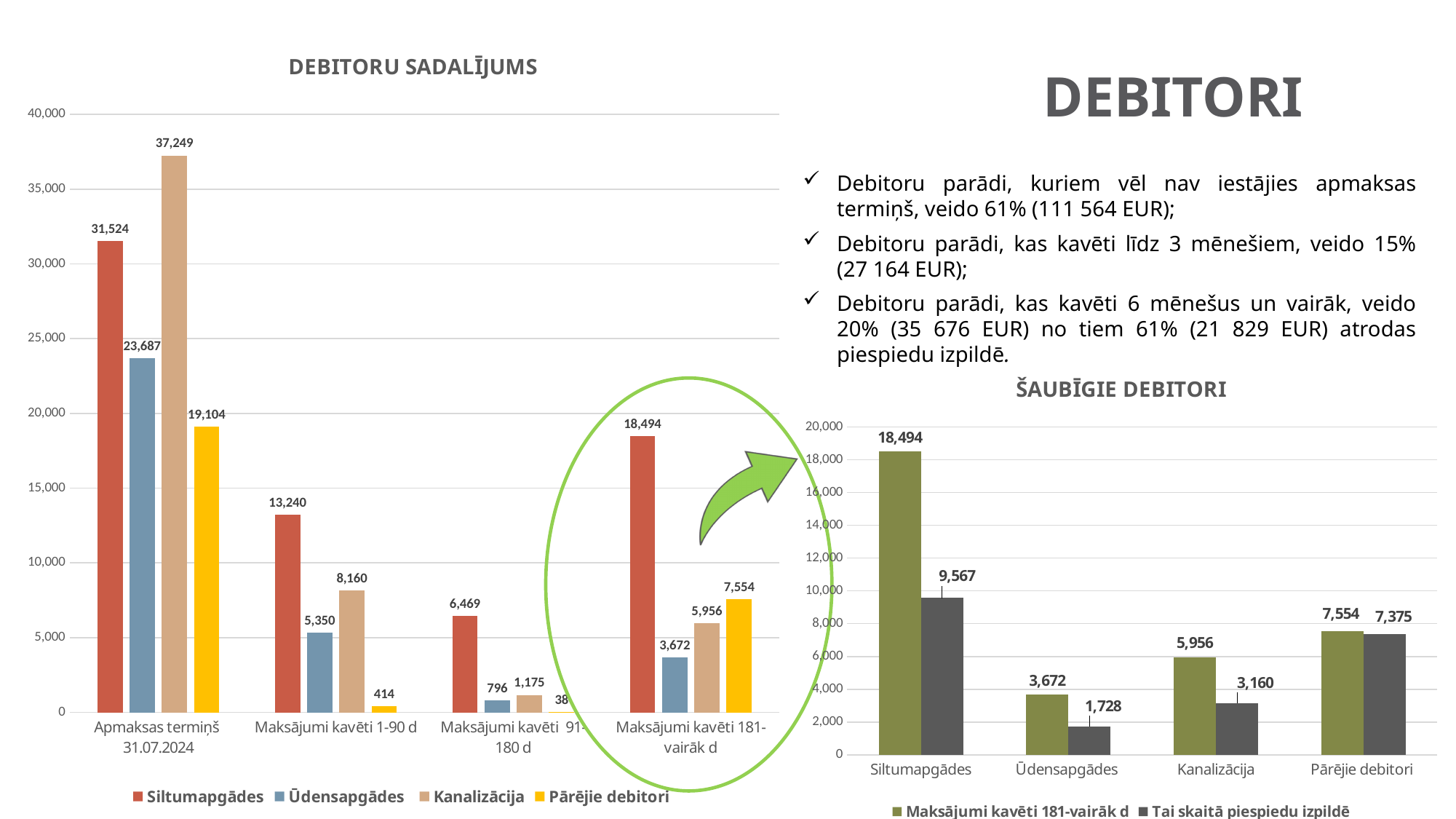
In the ŠAUBĪGIE DEBITORI chart, what is the difference between the two series for Pārējie debitori? 179 In the DEBITORU SADALĪJUMS chart, what is the value for Kanalizācija in the Apmaksas termiņš 31.07.2024 category? 37,249 In the DEBITORU SADALĪJUMS chart, what is the difference between Siltumapgādes and Ūdensapgādes in the Maksājumi kavēti 1-90 d category? 7,890 In the DEBITORU SADALĪJUMS chart, is the value for Siltumapgādes in the Apmaksas termiņš 31.07.2024 category greater or less than 30,000? greater In the DEBITORU SADALĪJUMS chart, how many series does the legend list? 4 In the ŠAUBĪGIE DEBITORI chart, what is the Tai skaitā piespiedu izpildē value for Siltumapgādes? 9,567 In the ŠAUBĪGIE DEBITORI chart, which category has the lowest Maksājumi kavēti 181-vairāk d value? Ūdensapgādes In the DEBITORU SADALĪJUMS chart, which series has the lowest value in the Maksājumi kavēti 181-vairāk d category? Ūdensapgādes In the ŠAUBĪGIE DEBITORI chart, how many categories are shown on the x axis? 4 What kind of chart is the ŠAUBĪGIE DEBITORI chart? Bar chart In the DEBITORU SADALĪJUMS chart, which series has the highest value in the Apmaksas termiņš 31.07.2024 category? Kanalizācija In the DEBITORU SADALĪJUMS chart, what is the value for Pārējie debitori in the Maksājumi kavēti 1-90 d category? 414